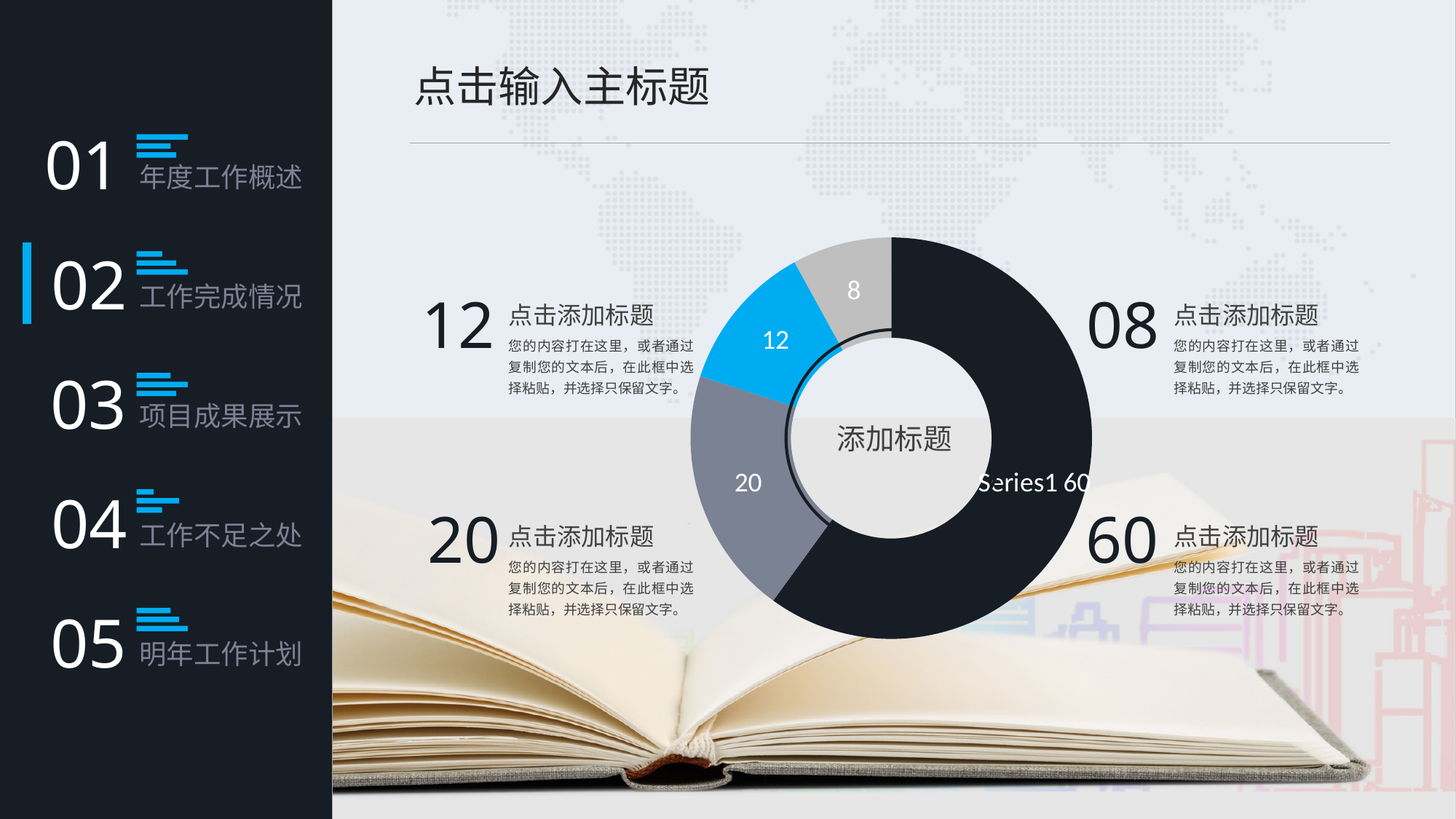
What value is printed on the light grey slice of the doughnut chart? 8 How many slices does the doughnut chart have? 4 What share of the doughnut chart does the slice labelled 60 represent? 60% What is the value of the largest slice of the doughnut chart? 60 Which is larger in the doughnut chart: the slice labelled 20 or the slice labelled 12? 20 What kind of chart is shown on the slide? doughnut chart What value is printed on the blue slice of the doughnut chart? 12 What is the total of all four slice values in the doughnut chart? 100 What text is shown in the centre of the doughnut chart? 添加标题 What is the difference between the largest slice (60) and the smallest slice (8) in the doughnut chart? 52 What value is printed on the dark navy slice of the doughnut chart? 60 What is the value of the smallest slice of the doughnut chart? 8